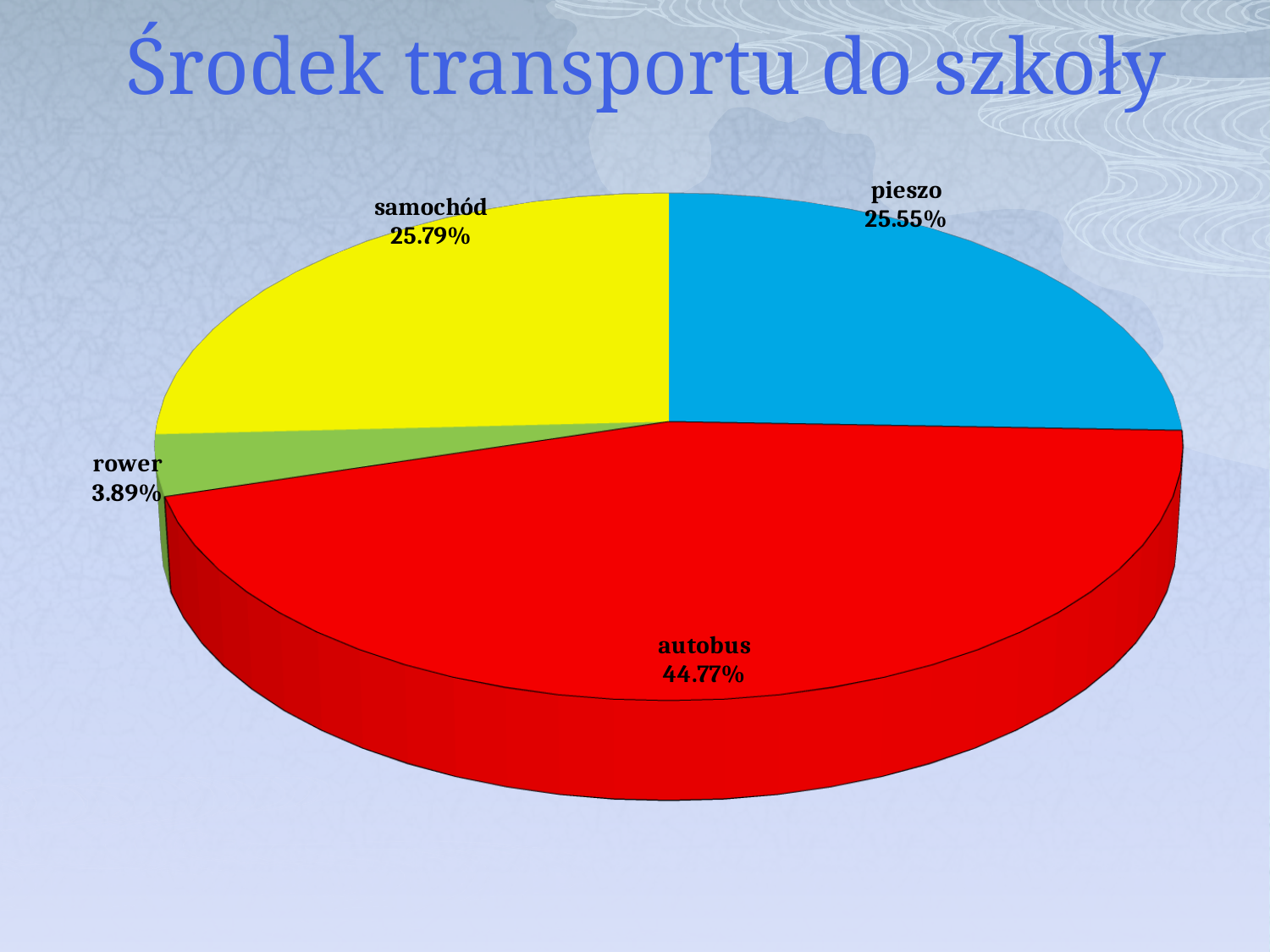
What share of the pie does autobus have? 44.77% What kind of chart is shown on the slide? pie chart Which category has the smallest slice of the pie? rower How many categories are shown in the pie chart? 4 What is the value shown for rower? 3.89% What is the value shown for samochód? 25.79% What is the title of the chart? Środek transportu do szkoły Which category has the largest slice of the pie? autobus What is the difference between the share for autobus and the share for pieszo? 19.22% What colour is the autobus slice? red What is the value shown for pieszo? 25.55% Which is larger, the share for samochód or the share for pieszo? samochód